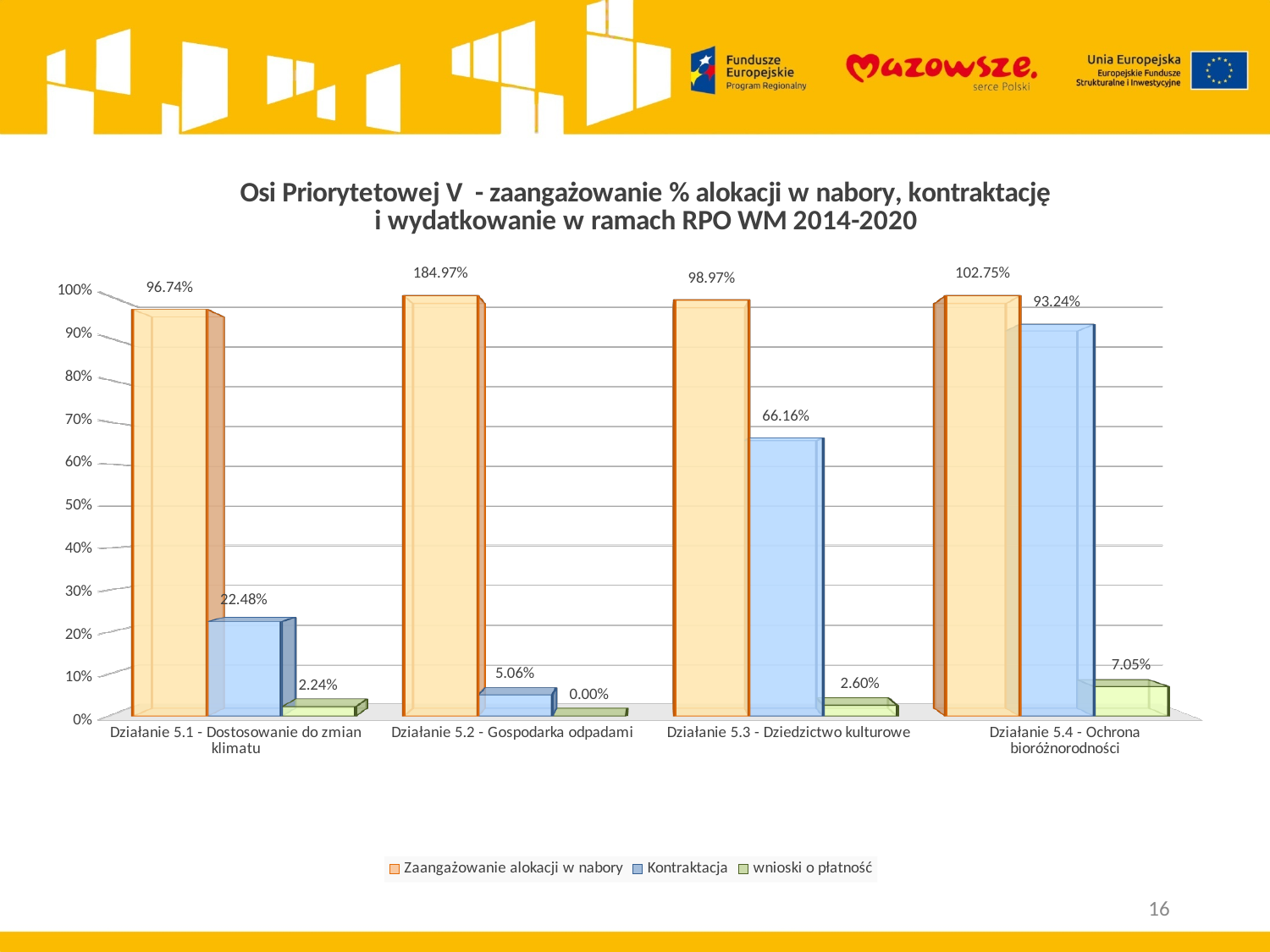
What is the Kontraktacja value for Działanie 5.3 - Dziedzictwo kulturowe? 66.16% Which category has the lowest wnioski o płatność value? Działanie 5.2 - Gospodarka odpadami What is the Kontraktacja value for Działanie 5.2 - Gospodarka odpadami? 5.06% Which category has the highest Kontraktacja value? Działanie 5.4 - Ochrona bioróżnorodności What is the wnioski o płatność value for Działanie 5.4 - Ochrona bioróżnorodności? 7.05% Which is larger: the Zaangażowanie alokacji w nabory value for Działanie 5.1 - Dostosowanie do zmian klimatu or for Działanie 5.4 - Ochrona bioróżnorodności? Działanie 5.4 - Ochrona bioróżnorodności What is the value of Zaangażowanie alokacji w nabory for Działanie 5.2 - Gospodarka odpadami? 184.97% What kind of chart is shown on the slide? Bar chart How many categories are shown on the x axis? 4 Which series is shown in blue in the legend? Kontraktacja How many series does the legend list? 3 What is the difference between the Kontraktacja values for Działanie 5.4 - Ochrona bioróżnorodności and Działanie 5.1 - Dostosowanie do zmian klimatu? 70.76%